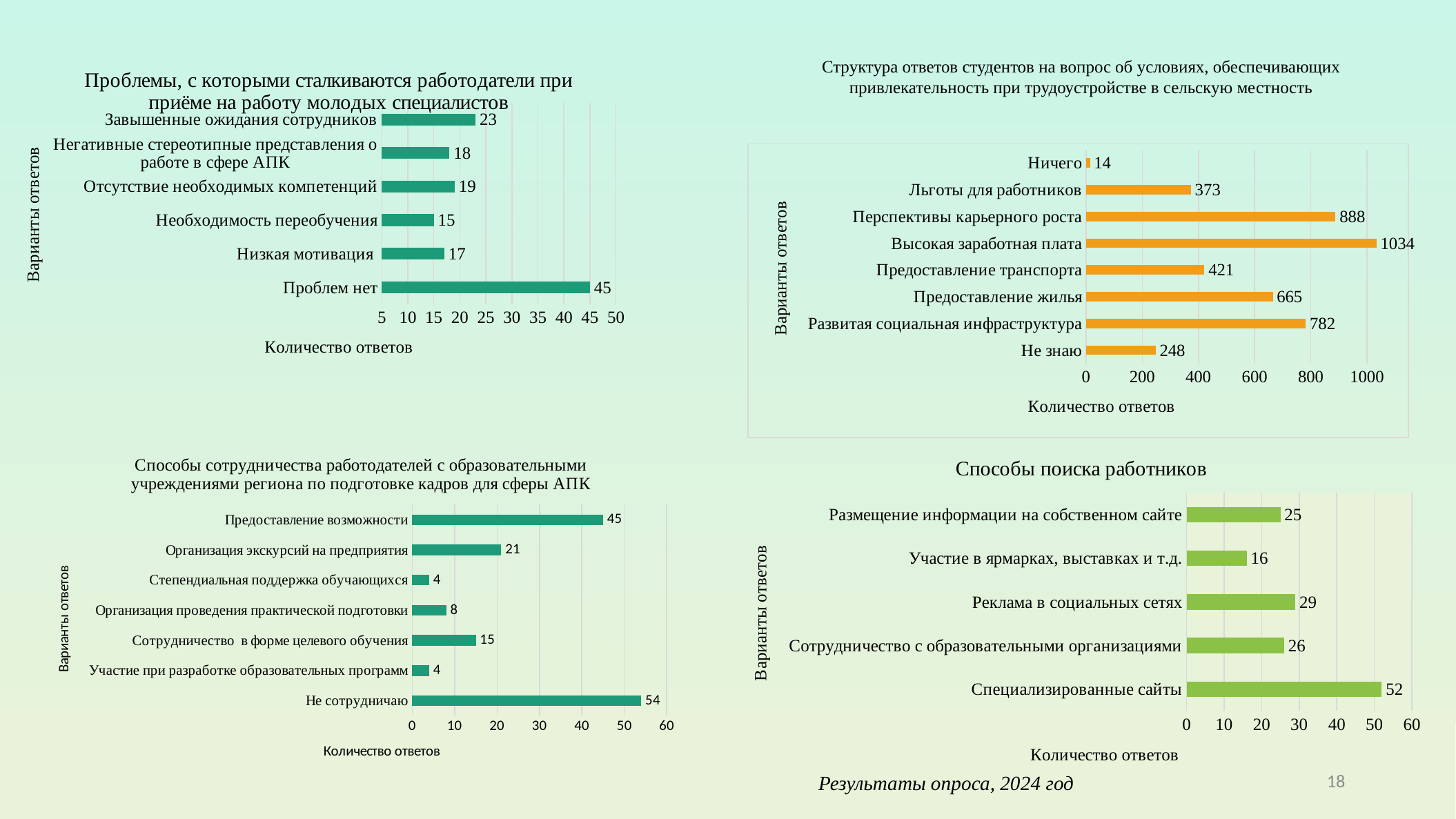
In the top-right chart about conditions attracting students to rural employment, what is the value for 'Высокая заработная плата'? 1034 In the chart 'Способы сотрудничества работодателей с образовательными учреждениями региона по подготовке кадров для сферы АПК', what is the value for 'Не сотрудничаю'? 54 In the chart 'Проблемы, с которыми сталкиваются работодатели при приёме на работу молодых специалистов', what is the value for 'Низкая мотивация'? 17 In the chart 'Способы сотрудничества работодателей с образовательными учреждениями региона по подготовке кадров для сферы АПК', how many categories are shown? 7 In the top-right chart about conditions attracting students to rural employment, which category has the lowest value? Ничего In the chart 'Проблемы, с которыми сталкиваются работодатели при приёме на работу молодых специалистов', which category has the highest value? Проблем нет In the chart 'Проблемы, с которыми сталкиваются работодатели при приёме на работу молодых специалистов', what is the difference between 'Завышенные ожидания сотрудников' and 'Необходимость переобучения'? 8 What type of chart is 'Способы поиска работников'? Bar chart In the chart 'Способы поиска работников', which category has the highest value? Специализированные сайты In the top-right chart about conditions attracting students to rural employment, which is larger: 'Предоставление жилья' or 'Развитая социальная инфраструктура'? Развитая социальная инфраструктура In the chart 'Способы поиска работников', what is the difference between 'Реклама в социальных сетях' and 'Участие в ярмарках, выставках и т.д.'? 13 In the top-right chart about conditions attracting students to rural employment, how many categories are shown? 8